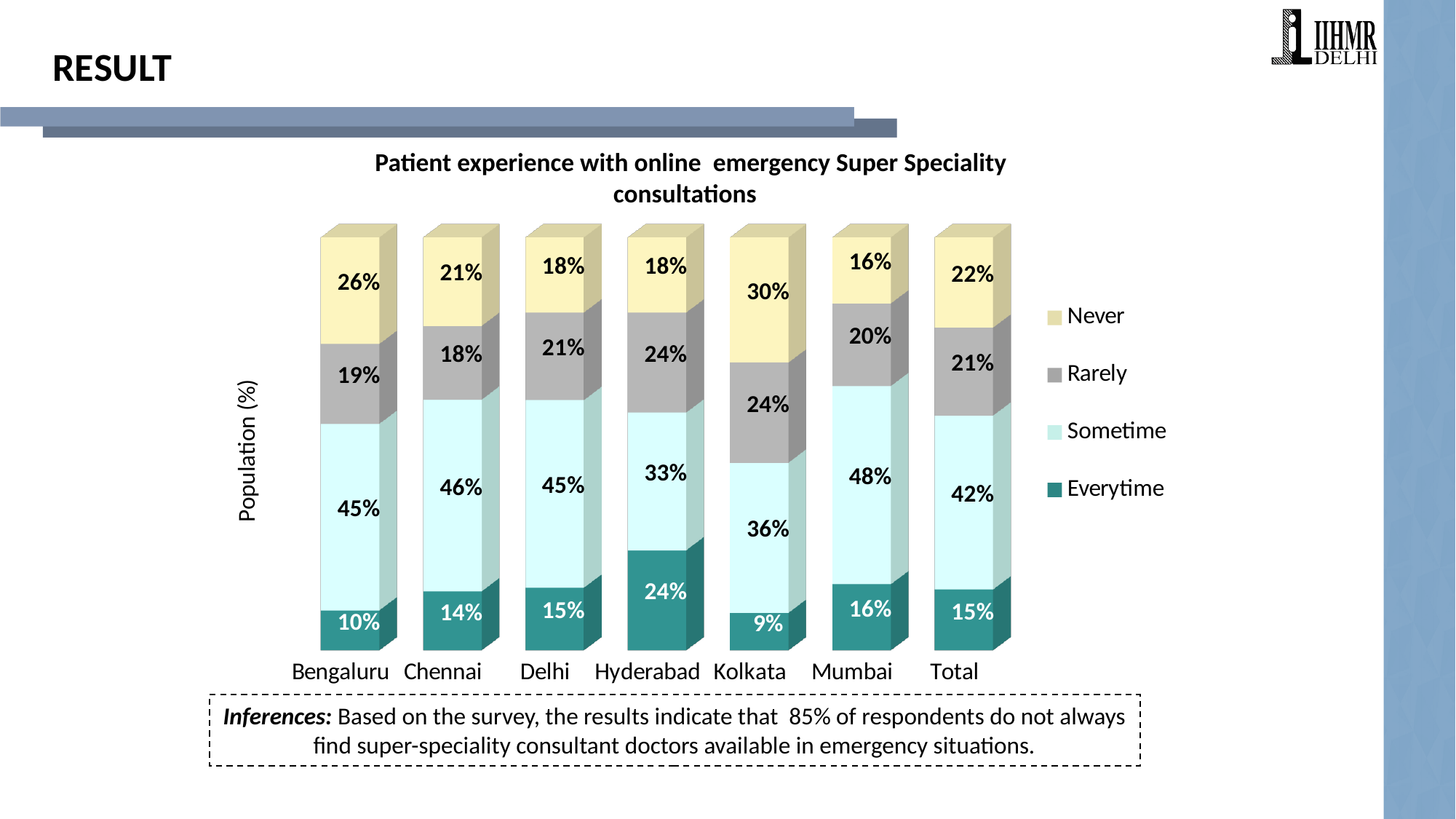
How many series does the legend list? 4 Which is larger, the 'Rarely' value for Delhi or the 'Rarely' value for Chennai? Delhi Which city has the highest 'Everytime' percentage? Hyderabad What type of chart is shown on the slide? Stacked bar chart Which city has the highest 'Never' percentage? Kolkata What percentage of respondents in Hyderabad reported 'Everytime'? 24% What is the 'Rarely' value for the Total bar? 21% How many city categories (including Total) are shown on the x axis? 7 Which city has the lowest 'Everytime' percentage? Kolkata What is the difference between the 'Sometime' values for Mumbai and Hyderabad? 15% What is the 'Sometime' value for Mumbai? 48% What is the 'Never' value for Kolkata? 30%